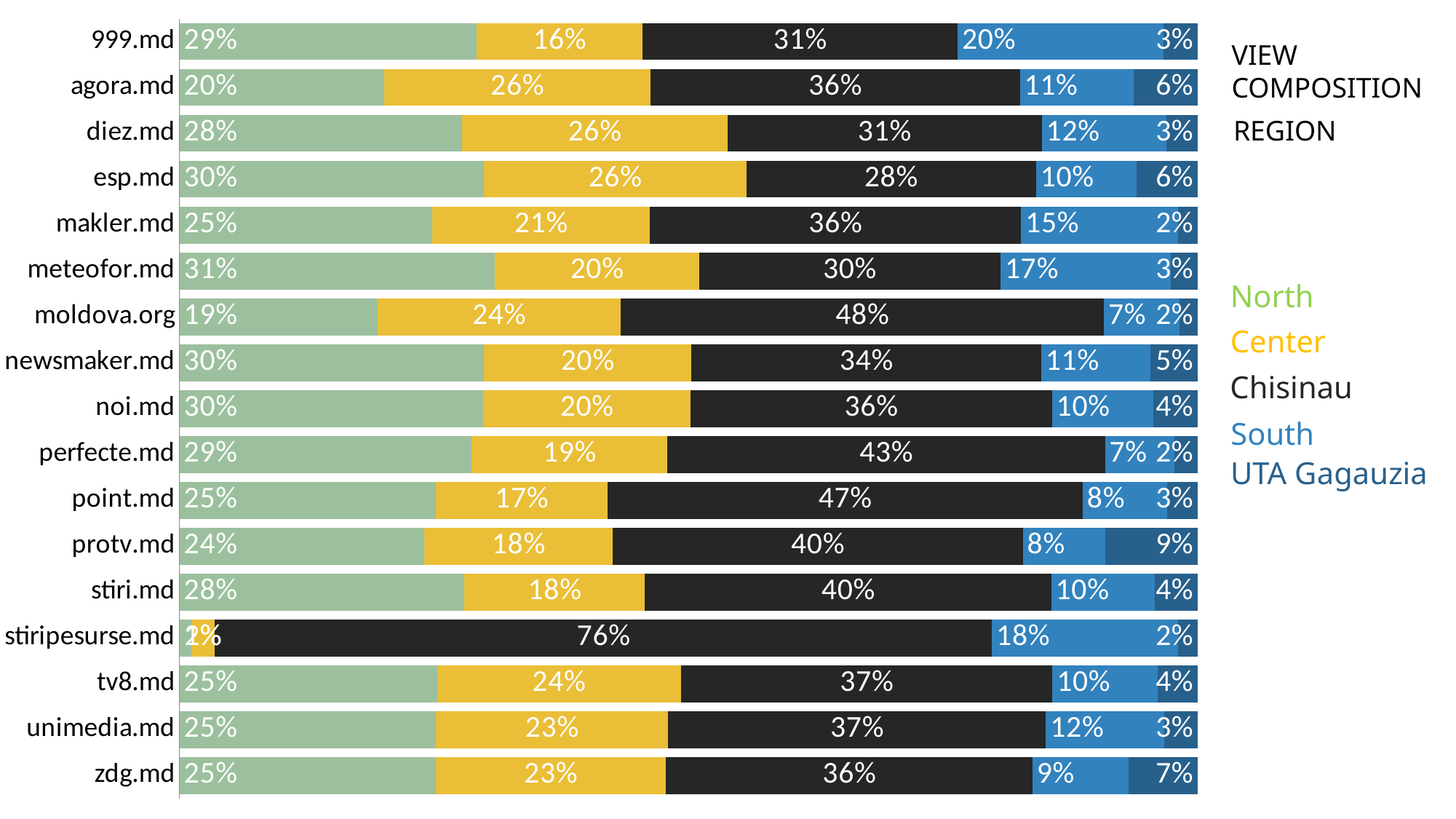
What is the UTA Gagauzia share for protv.md? 9% How many regions does the legend list? 5 Which has a larger North share, esp.md or agora.md? esp.md What is the difference between the Chisinau share of moldova.org and that of 999.md? 17 percentage points Which website has the highest South share? 999.md What is the Chisinau share for moldova.org? 48% How many websites are shown in the chart? 17 What is the Center share for agora.md? 26% Which website has the lowest Chisinau share? esp.md Which website has the highest Chisinau share? stiripesurse.md What is the South share for 999.md? 20% What is the North share for meteofor.md? 31%